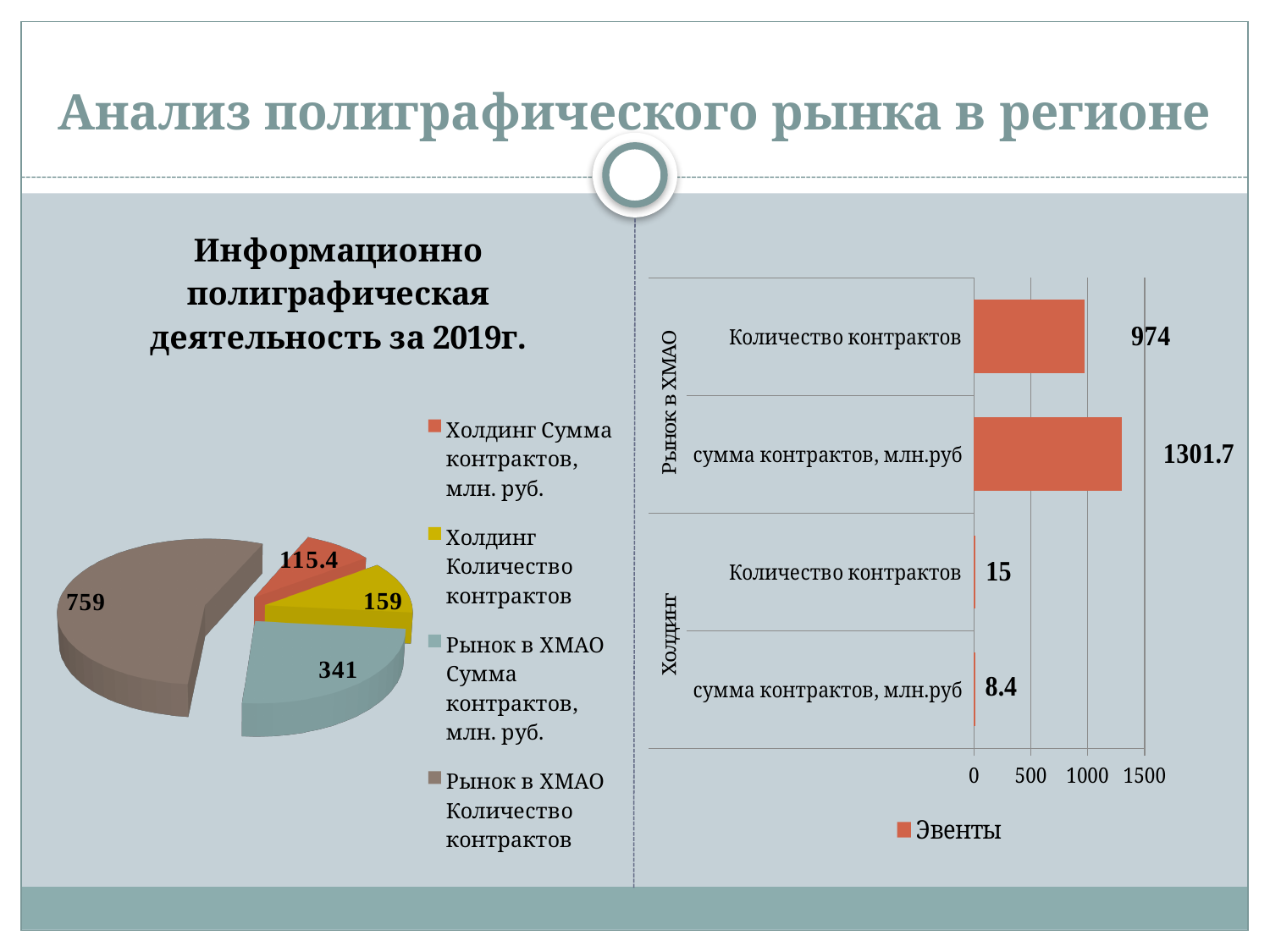
In the right bar chart, which is larger: "Количество контрактов" for "Холдинг" or "сумма контрактов, млн.руб" for "Холдинг"? Количество контрактов In the right bar chart, what is the value for "сумма контрактов, млн.руб" under "Рынок в ХМАО"? 1301.7 In the left pie chart, what is the difference between the values for "Рынок в ХМАО Количество контрактов" and "Рынок в ХМАО Сумма контрактов, млн. руб."? 418 In the left pie chart, what is the value for "Рынок в ХМАО Количество контрактов"? 759 In the left pie chart, which slice is the smallest? Холдинг Сумма контрактов, млн. руб. In the left pie chart, which slice is the largest? Рынок в ХМАО Количество контрактов In the left pie chart, what is the value for "Холдинг Сумма контрактов, млн. руб."? 115.4 What type of chart is the left chart titled "Информационно полиграфическая деятельность за 2019г."? pie chart What type of chart is the right chart with the legend "Эвенты"? bar chart In the right bar chart, what is the value for "Количество контрактов" under "Холдинг"? 15 In the right bar chart, what is the difference between "сумма контрактов, млн.руб" and "Количество контрактов" for "Рынок в ХМАО"? 327.7 In the left pie chart, how many slices are there? 4